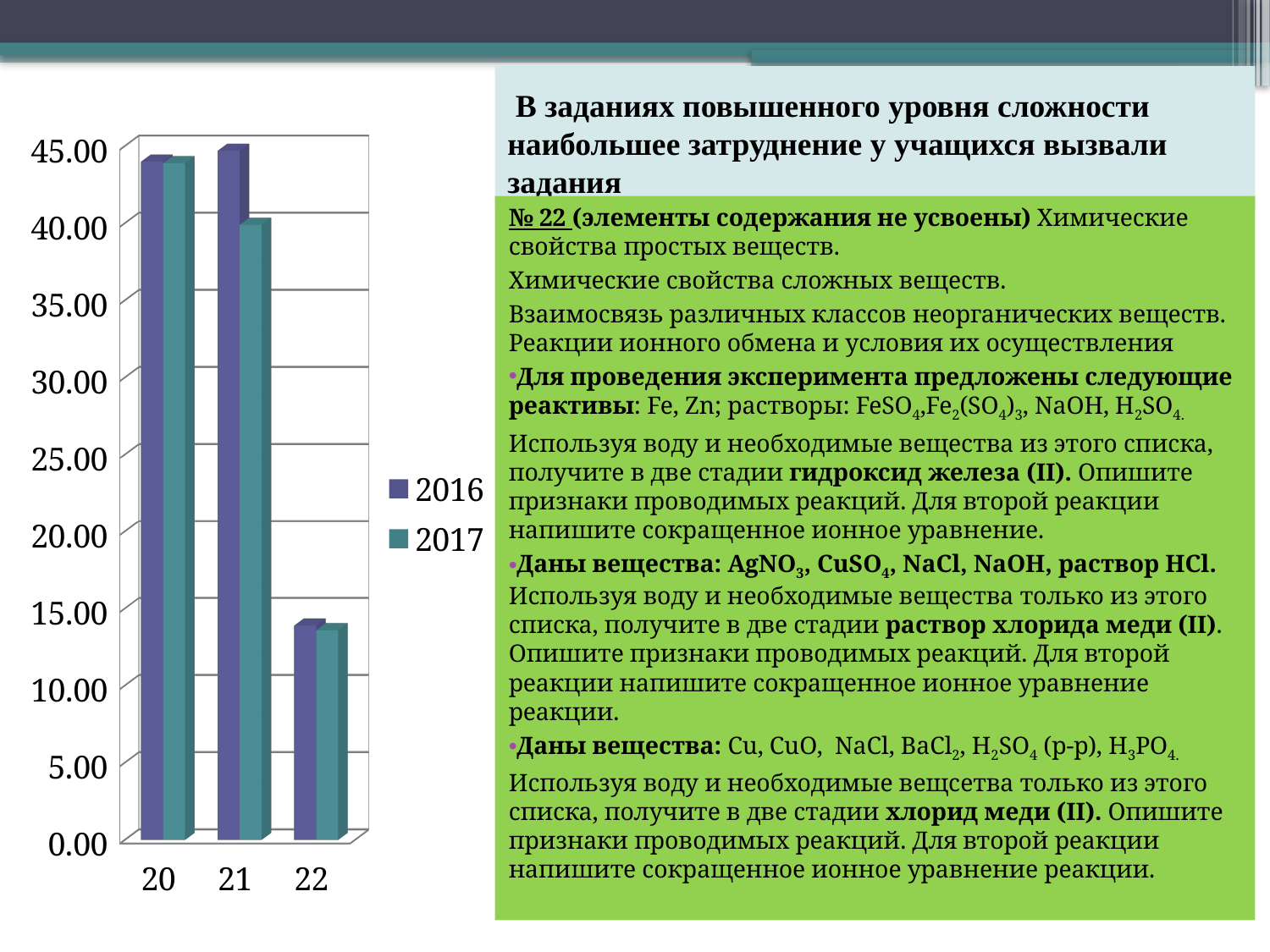
Is the 2016 value for category 20 greater or less than 40.00? greater How many categories are shown on the x axis of the chart? 3 Which category has the lowest value for the 2016 series? 22 Is the 2017 value for category 21 greater or less than 35.00? greater What kind of chart is shown on the slide? bar chart Is the 2017 value for category 22 greater or less than 20.00? less How many series does the chart legend list? 2 Which category has the highest value for the 2017 series? 20 Which series are listed in the chart legend? 2016 and 2017 For category 21, which series has the larger value, 2016 or 2017? 2016 Which colour represents the 2017 series in the chart? teal